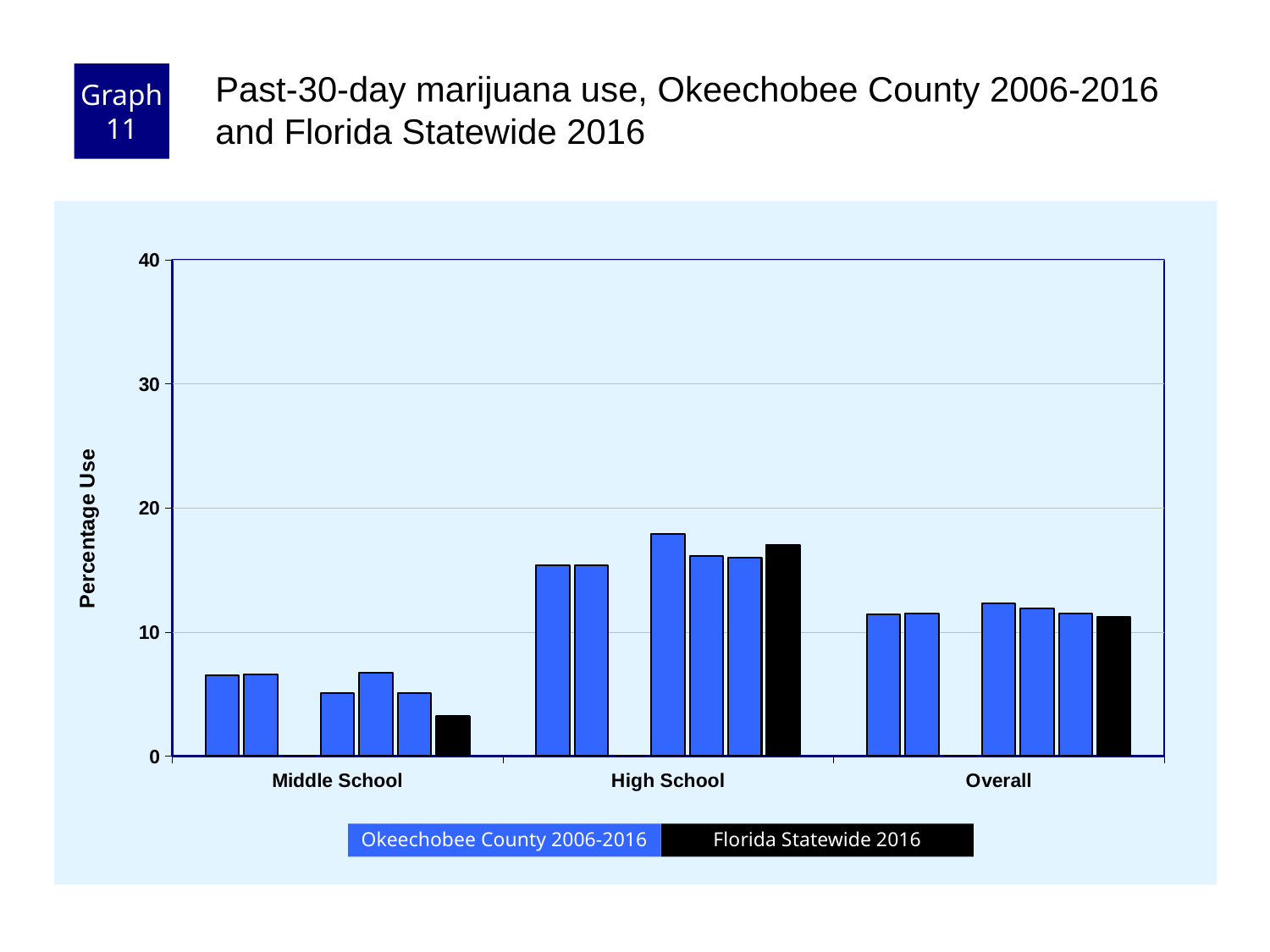
Is the Florida Statewide 2016 value for High School greater or less than 20? less Which category has the highest Florida Statewide 2016 value? High School Which category has the lowest Florida Statewide 2016 value? Middle School Is the Florida Statewide 2016 value for High School greater or less than 10? greater What kind of chart is shown on the slide? bar chart Which is larger, the Florida Statewide 2016 value for High School or for Middle School? High School Is the Florida Statewide 2016 value for Overall greater or less than 10? greater What is the label on the y axis of the chart? Percentage Use How many series does the chart legend list? 2 Which series is shown in black in the chart legend? Florida Statewide 2016 How many categories are shown on the x axis of the chart? 3